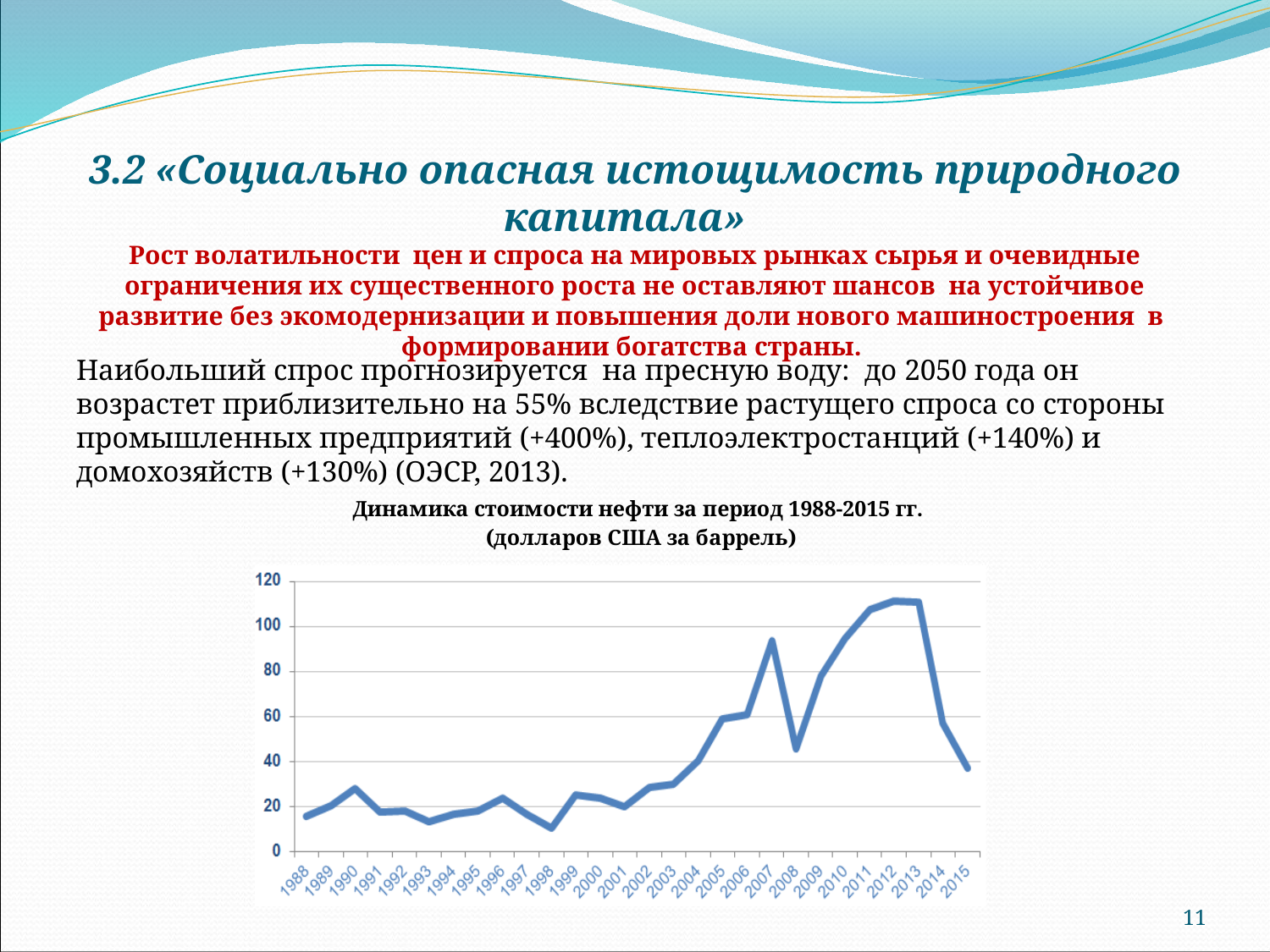
Is the value for 2003 greater or less than 20? greater Is the value for 1998 greater or less than 20? less What kind of chart is shown on the slide? line chart Does the oil price rise or fall from 2013 to 2015? fall What is the title of the chart? Динамика стоимости нефти за период 1988-2015 гг. (долларов США за баррель) Is the value for 2011 greater or less than 100? greater Which year has the lowest oil price on the chart? 1998 Which year has the higher oil price, 2007 or 2008? 2007 Does the oil price rise or fall from 2003 to 2007? rise How many years are plotted on the x axis of the chart? 28